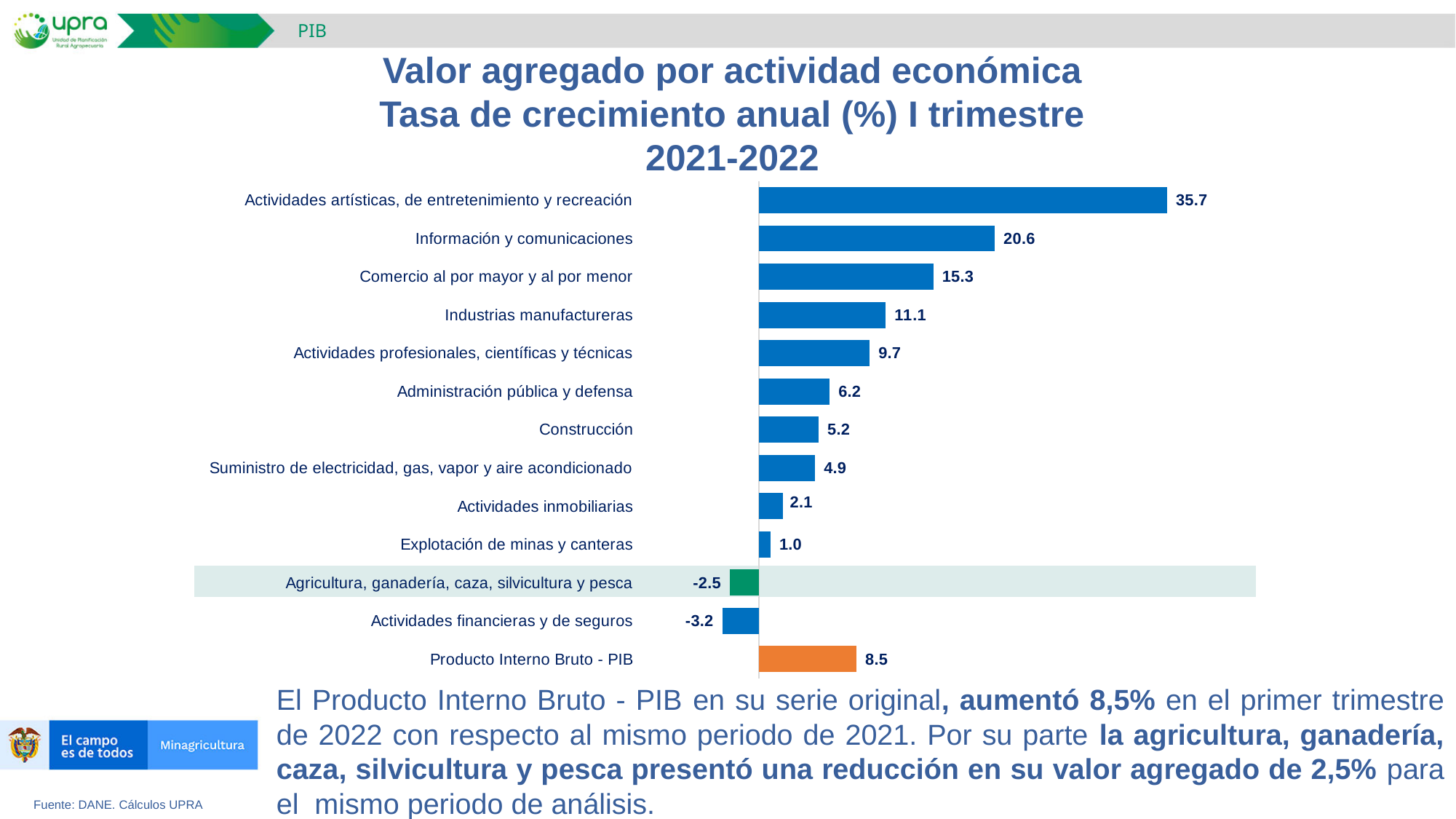
What is the annual growth rate shown for Información y comunicaciones? 20.6 What is the value shown for Producto Interno Bruto - PIB? 8.5 What value is shown for Agricultura, ganadería, caza, silvicultura y pesca? -2.5 Which has a larger value, Construcción or Suministro de electricidad, gas, vapor y aire acondicionado? Construcción What is the difference between the values for Comercio al por mayor y al por menor and Industrias manufactureras? 4.2 What type of chart is shown on the slide? Bar chart How many categories show a negative growth rate? 2 What is the difference between the value for Actividades artísticas, de entretenimiento y recreación and Producto Interno Bruto - PIB? 27.2 Which activity has the highest growth rate in the chart? Actividades artísticas, de entretenimiento y recreación What colour is the bar for Producto Interno Bruto - PIB? Orange How many categories (bars) are plotted in the chart? 13 Which activity has the lowest growth rate in the chart? Actividades financieras y de seguros